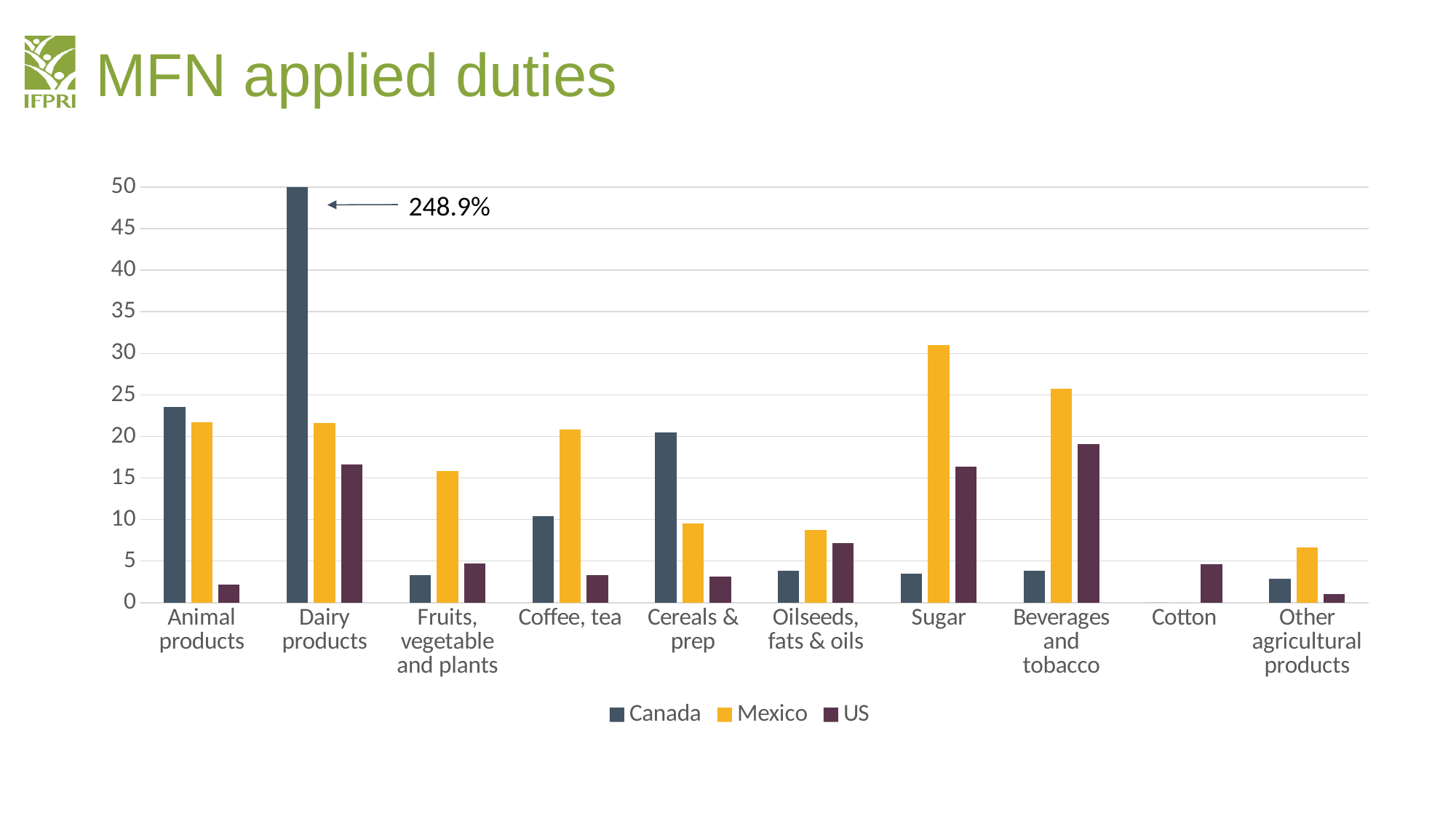
For which category is only a US bar shown? Cotton How many series does the legend list? 3 For Beverages and tobacco, which is larger: the Mexico value or the US value? Mexico Which category has the highest Mexico value? Sugar Which series has the highest value for Sugar? Mexico Is the Canada value for Coffee, tea greater or less than 15? less What is the title of the chart? MFN applied duties Is the US value for Beverages and tobacco greater or less than 15? greater What kind of chart is shown on the slide? bar chart How many product categories are shown on the x axis? 10 What value is annotated for the Canada bar in Dairy products? 248.9% Is the Mexico value for Sugar greater or less than 25? greater